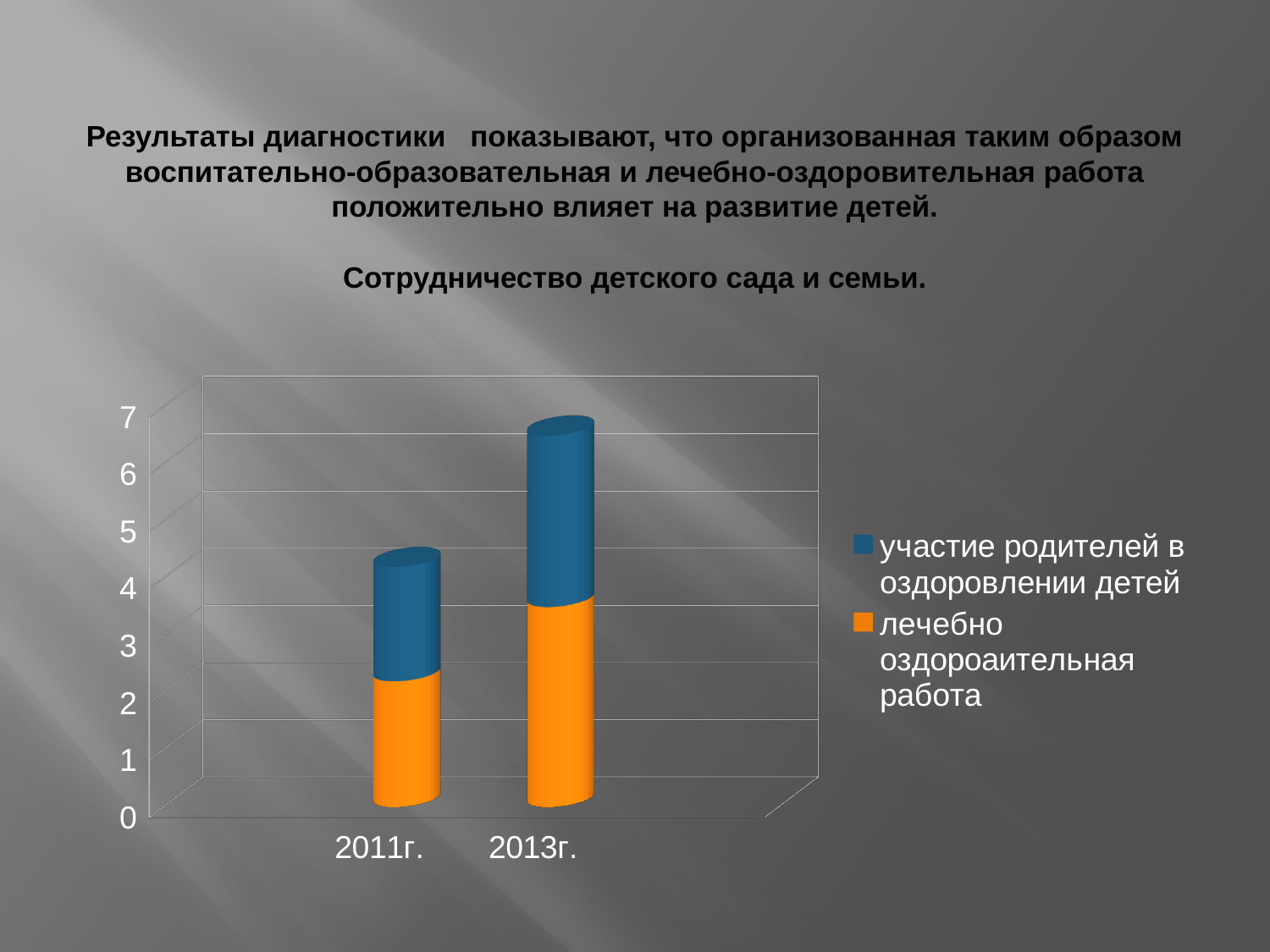
Which colour represents 'участие родителей в оздоровлении детей' in the chart? blue Which series is shown at the bottom of each stacked bar? лечебно оздороаительная работа Which year has the larger value for 'лечебно оздороаительная работа', 2011г. or 2013г.? 2013г. Which category has the taller stacked bar, 2011г. or 2013г.? 2013г. Is the total height of the stacked bar for 2013г. greater or less than 6? greater Do the stacked bar totals rise or fall from 2011г. to 2013г.? rise Is the total height of the stacked bar for 2011г. greater or less than 5? less Is the value of 'лечебно оздороаительная работа' for 2011г. greater or less than 3? less What kind of chart is shown on the slide? stacked bar chart How many categories are shown on the x axis of the chart? 2 How many series does the chart legend list? 2